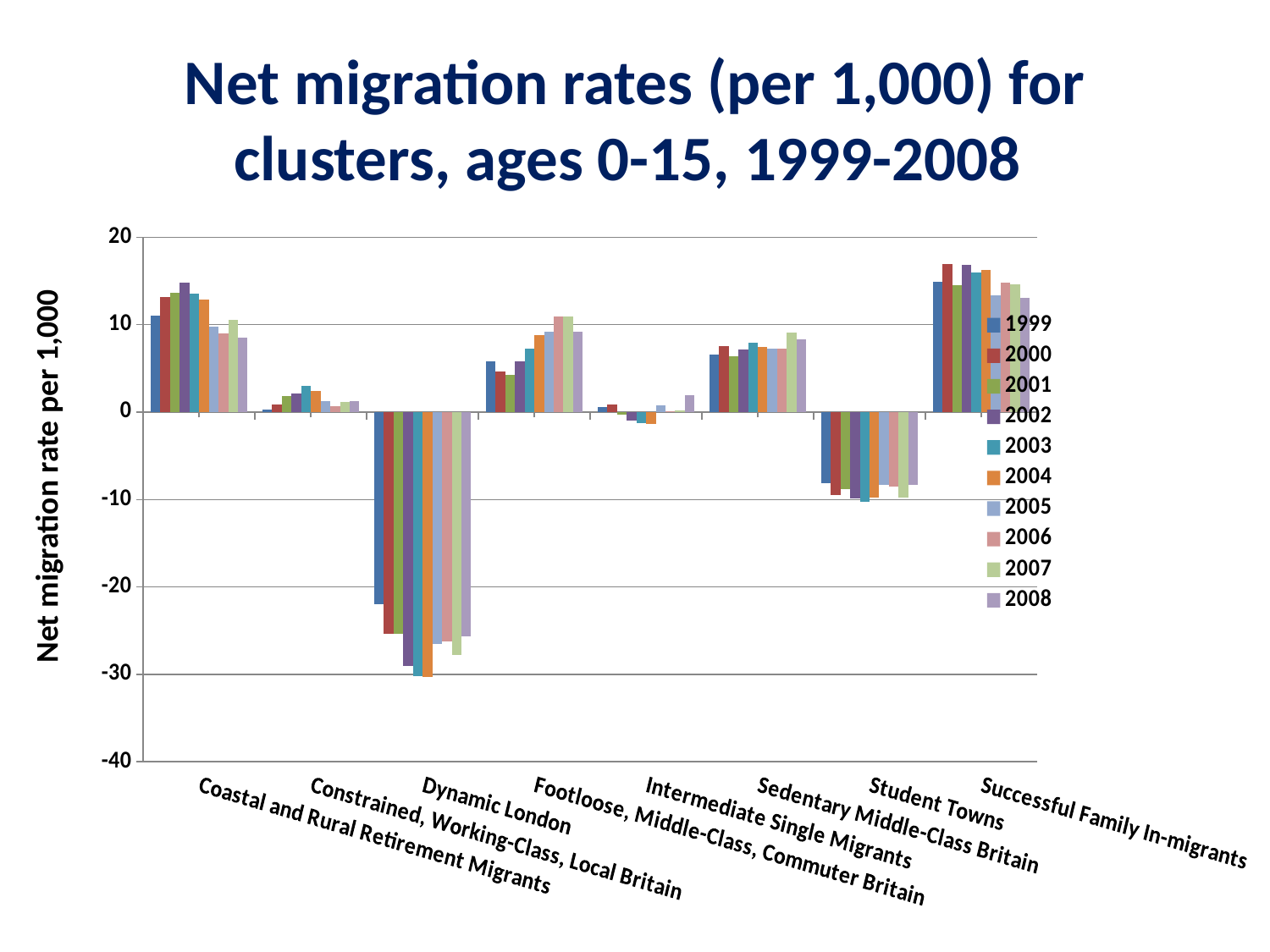
Is the 2004 value for Footloose, Middle-Class, Commuter Britain greater or less than 10? less How many clusters (categories) are shown along the x axis? 8 Is the 2003 value for Dynamic London greater or less than -20? less What kind of chart is shown on the slide? bar chart Which cluster has the highest net migration rates? Successful Family In-migrants Is the 1999 value for Successful Family In-migrants greater or less than 10? greater Which cluster has the lowest (most negative) net migration rates? Dynamic London What is the label on the vertical axis? Net migration rate per 1,000 For Dynamic London, which year has the lower value, 2003 or 2008? 2003 For Successful Family In-migrants, which year has the larger value, 2000 or 2008? 2000 How many years (series) does the legend list? 10